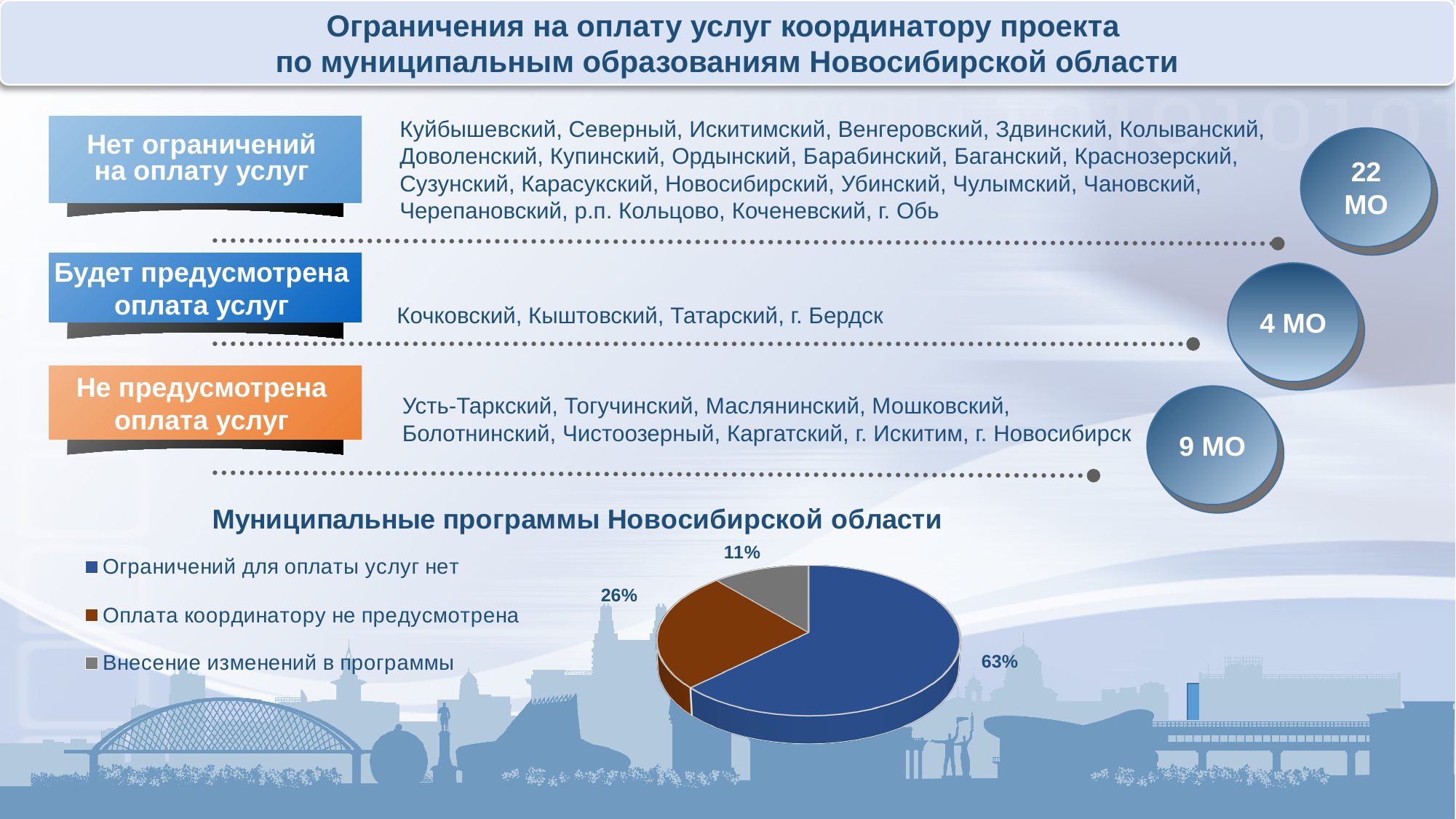
What colour is the slice for "Внесение изменений в программы" in the pie chart? grey What is the share for "Оплата координатору не предусмотрена" in the pie chart? 26% What is the title of the pie chart? Муниципальные программы Новосибирской области What is the share for "Внесение изменений в программы" in the pie chart? 11% Which category has the smallest slice in the pie chart? Внесение изменений в программы Which is larger in the pie chart: "Оплата координатору не предусмотрена" or "Внесение изменений в программы"? Оплата координатору не предусмотрена Which category has the largest slice in the pie chart? Ограничений для оплаты услуг нет What is the share for "Ограничений для оплаты услуг нет" in the pie chart? 63% How many slices does the pie chart have? 3 What type of chart is shown under the title "Муниципальные программы Новосибирской области"? pie chart What is the difference in percentage points between the "Оплата координатору не предусмотрена" slice and the "Внесение изменений в программы" slice? 15 What is the difference in percentage points between the "Ограничений для оплаты услуг нет" slice and the "Оплата координатору не предусмотрена" slice? 37